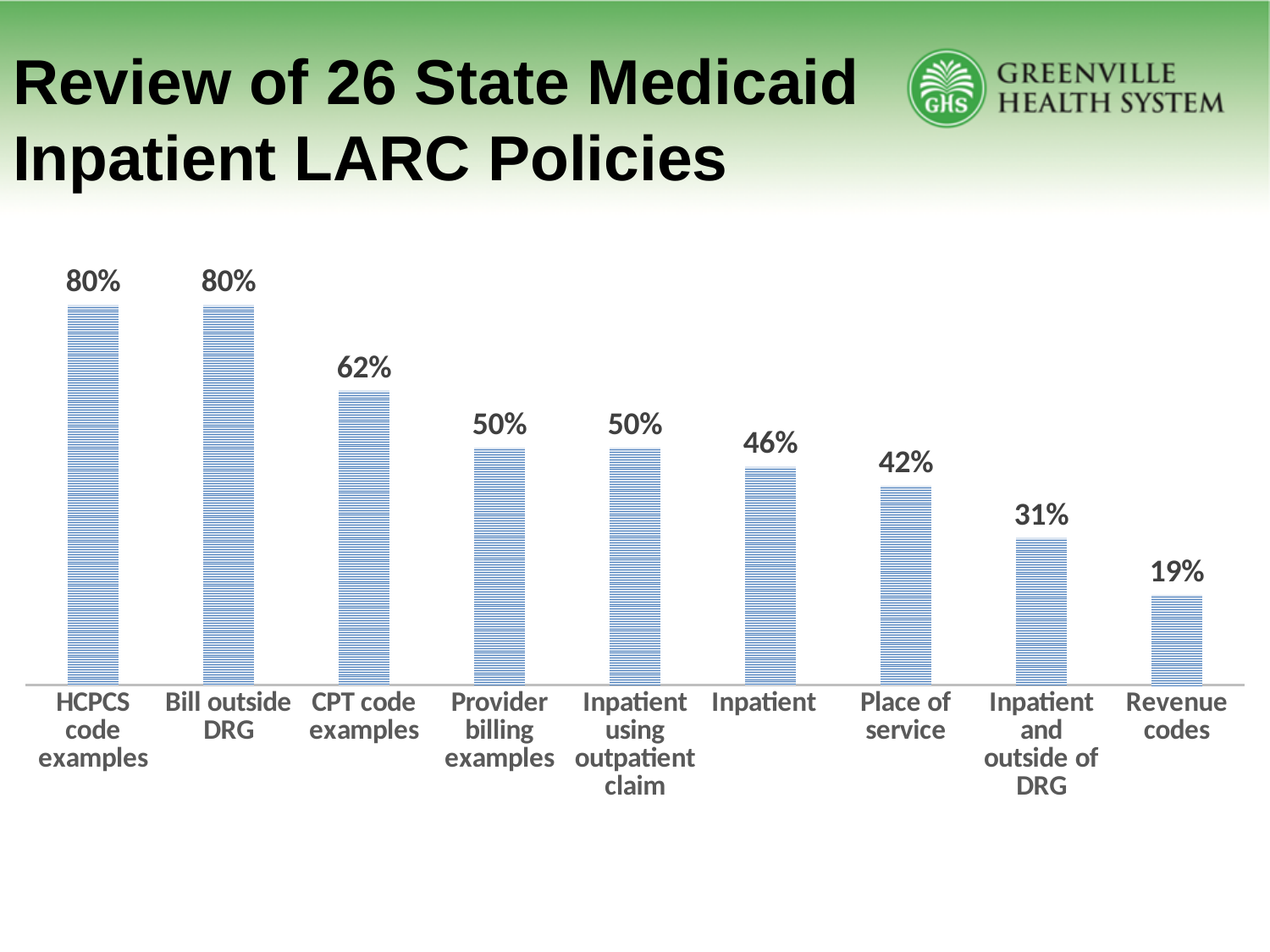
What kind of chart is shown on the slide? Bar chart What is the difference between the values for CPT code examples and Inpatient? 16% Which category has the lowest value? Revenue codes What is the difference between the values for HCPCS code examples and Revenue codes? 61% How many categories are shown in the chart? 9 Which is larger, the value for Place of service or the value for Inpatient and outside of DRG? Place of service Do the values rise or fall from left to right along the x axis? Fall What is the value for Inpatient and outside of DRG? 31% What is the value for CPT code examples? 62% Which two categories share the highest value of 80%? HCPCS code examples and Bill outside DRG What is the value for Place of service? 42% What is the value for Revenue codes? 19%